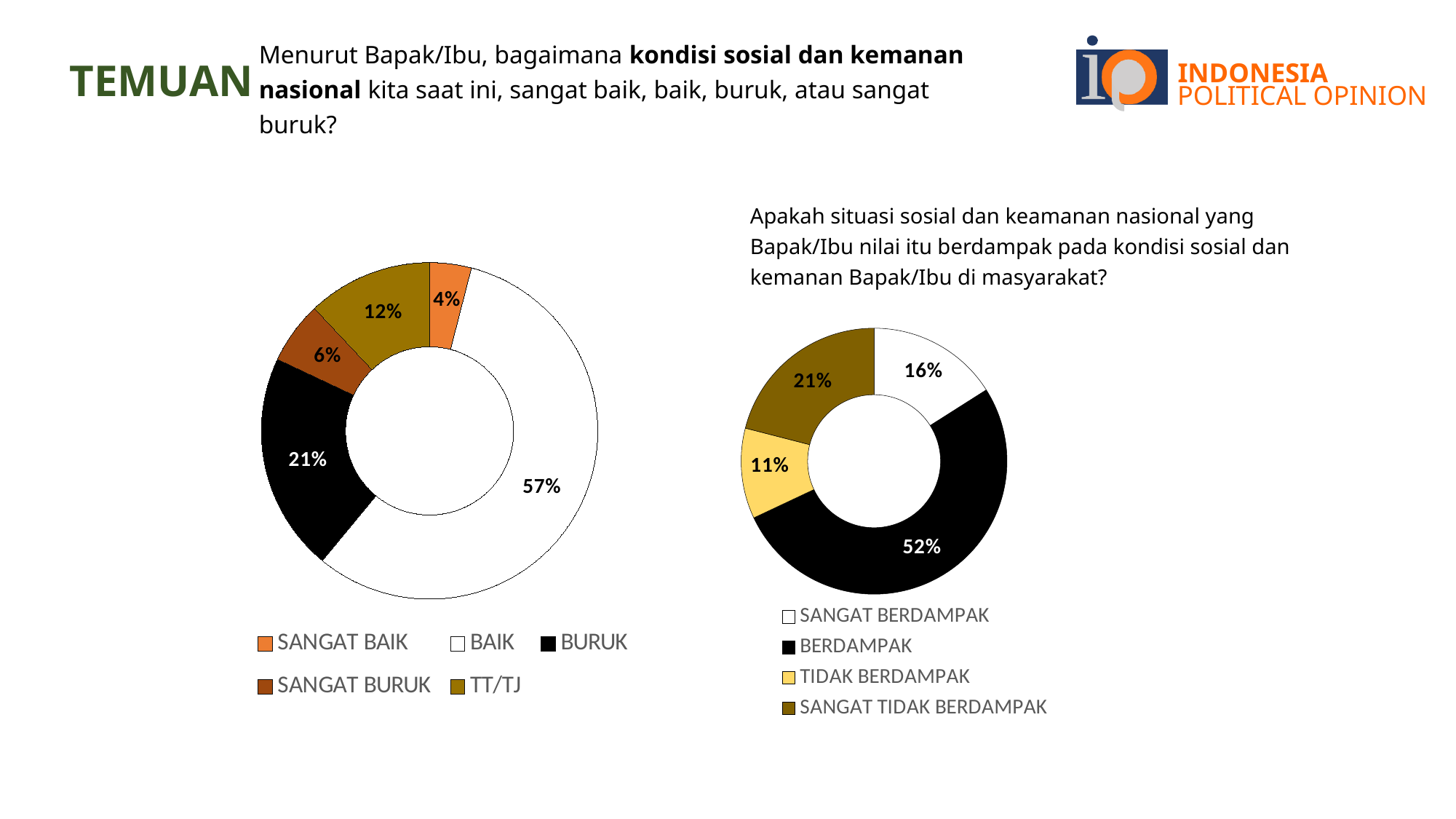
In the left chart (kondisi sosial dan keamanan nasional), which category has the smallest share? SANGAT BAIK In the left chart (kondisi sosial dan keamanan nasional), how many categories does the legend list? 5 In the right chart (berdampak pada kondisi sosial dan keamanan), which is larger, SANGAT BERDAMPAK or SANGAT TIDAK BERDAMPAK? SANGAT TIDAK BERDAMPAK In the right chart (berdampak pada kondisi sosial dan keamanan), what is the difference between BERDAMPAK and SANGAT BERDAMPAK? 36% What type of chart is used on the left side of the slide? Doughnut chart In the left chart (kondisi sosial dan keamanan nasional), what percentage is shown for BAIK? 57% In the right chart (berdampak pada kondisi sosial dan keamanan), what percentage is shown for TIDAK BERDAMPAK? 11% In the left chart (kondisi sosial dan keamanan nasional), which category has the largest share? BAIK In the right chart (berdampak pada kondisi sosial dan keamanan), what percentage is shown for BERDAMPAK? 52% In the right chart (berdampak pada kondisi sosial dan keamanan), which category has the largest share? BERDAMPAK In the left chart (kondisi sosial dan keamanan nasional), what percentage is shown for SANGAT BURUK? 6% In the left chart (kondisi sosial dan keamanan nasional), what is the difference between BAIK and BURUK? 36%